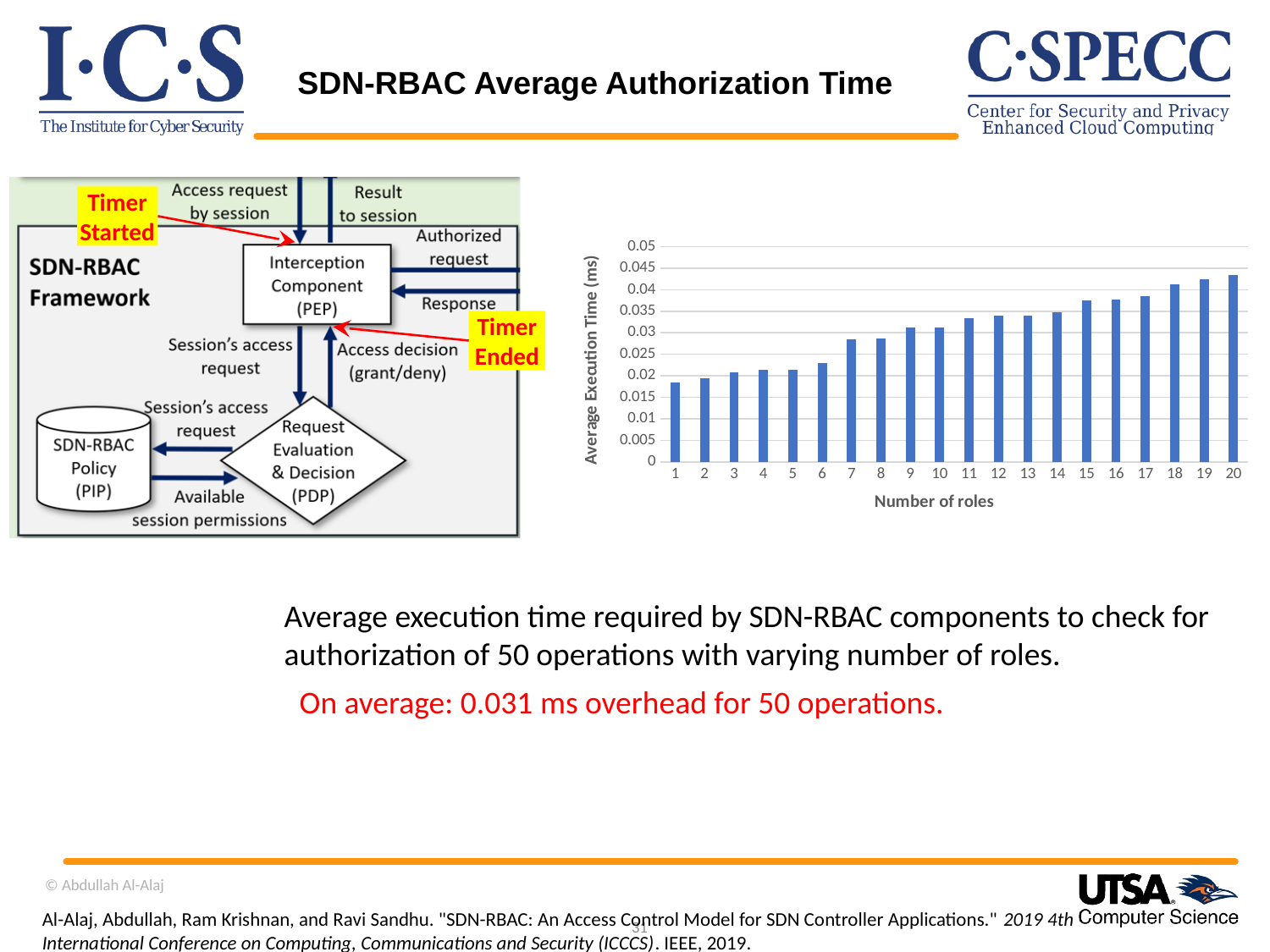
Which number of roles has the lowest average execution time in the chart? 1 Is the average execution time for 7 roles greater or less than 0.025 ms? greater Is the average execution time for 20 roles greater or less than 0.04 ms? greater Is the average execution time for 6 roles greater or less than 0.025 ms? less How many categories (number of roles) are plotted on the x axis of the chart? 20 What is the label of the y axis of the chart? Average Execution Time (ms) Do the average execution times rise or fall as the number of roles increases along the x axis? rise Which number of roles has the highest average execution time in the chart? 20 Which has a larger average execution time: 5 roles or 14 roles? 14 roles What kind of chart is shown on the slide? bar chart